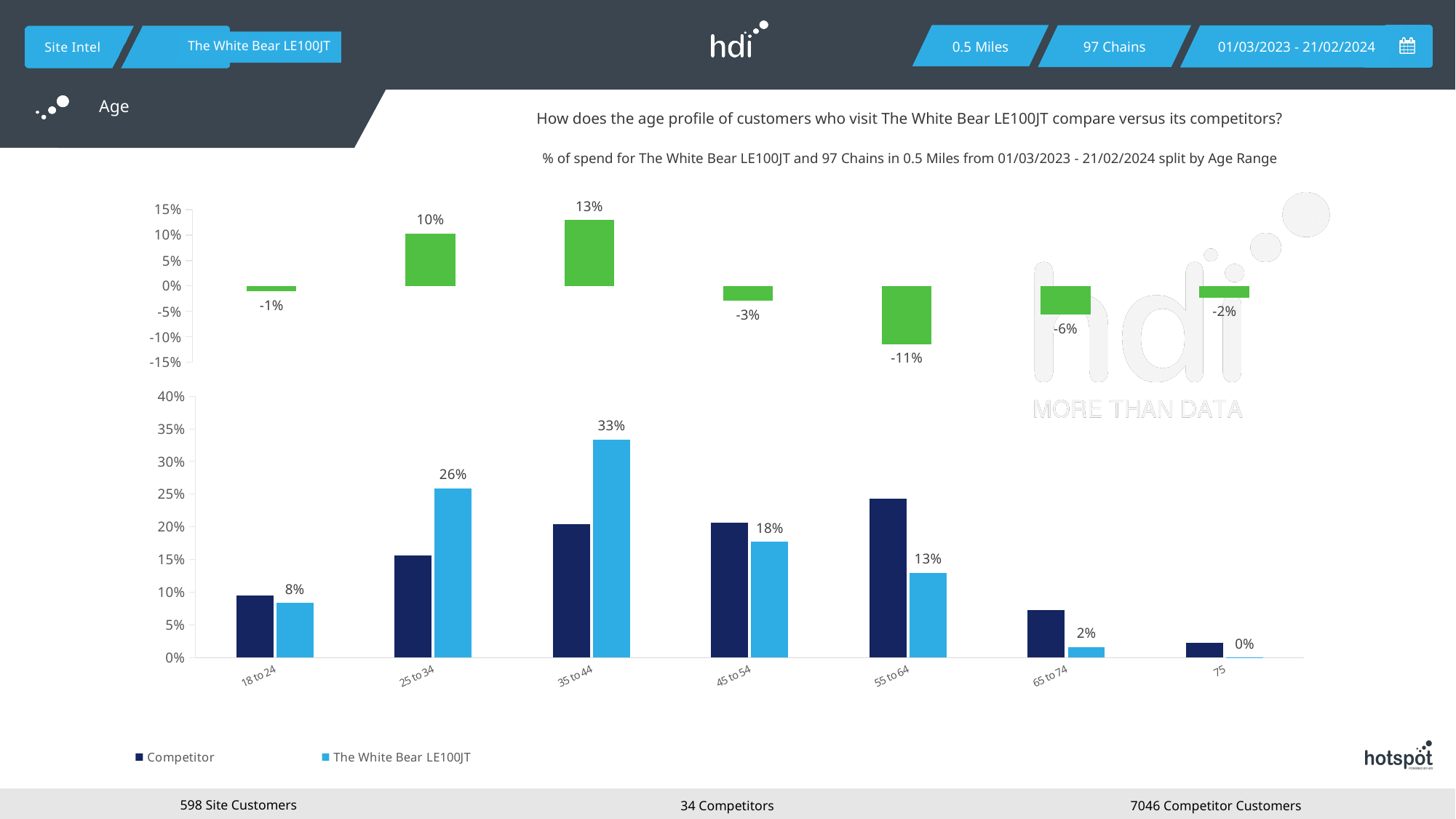
In the top chart, what is the value shown for the 55 to 64 age range? -11% In the bottom chart, is the Competitor value for 55 to 64 greater or less than 20%? greater What type of chart is the bottom chart? Bar chart In the top chart, what is the value shown for the 25 to 34 age range? 10% How many series does the legend of the bottom chart list? 2 In the top chart, which age range has the lowest value? 55 to 64 In the bottom chart, what is the difference between The White Bear LE100JT values for 35 to 44 and 45 to 54? 15% In the bottom chart, which age range has the highest value for The White Bear LE100JT? 35 to 44 In the bottom chart, what is the value for The White Bear LE100JT in the 25 to 34 age range? 26% In the bottom chart, which is larger for The White Bear LE100JT: the 18 to 24 value or the 55 to 64 value? 55 to 64 In the bottom chart, what is the value for The White Bear LE100JT in the 35 to 44 age range? 33% How many age range categories are shown on the x axis of the bottom chart? 7